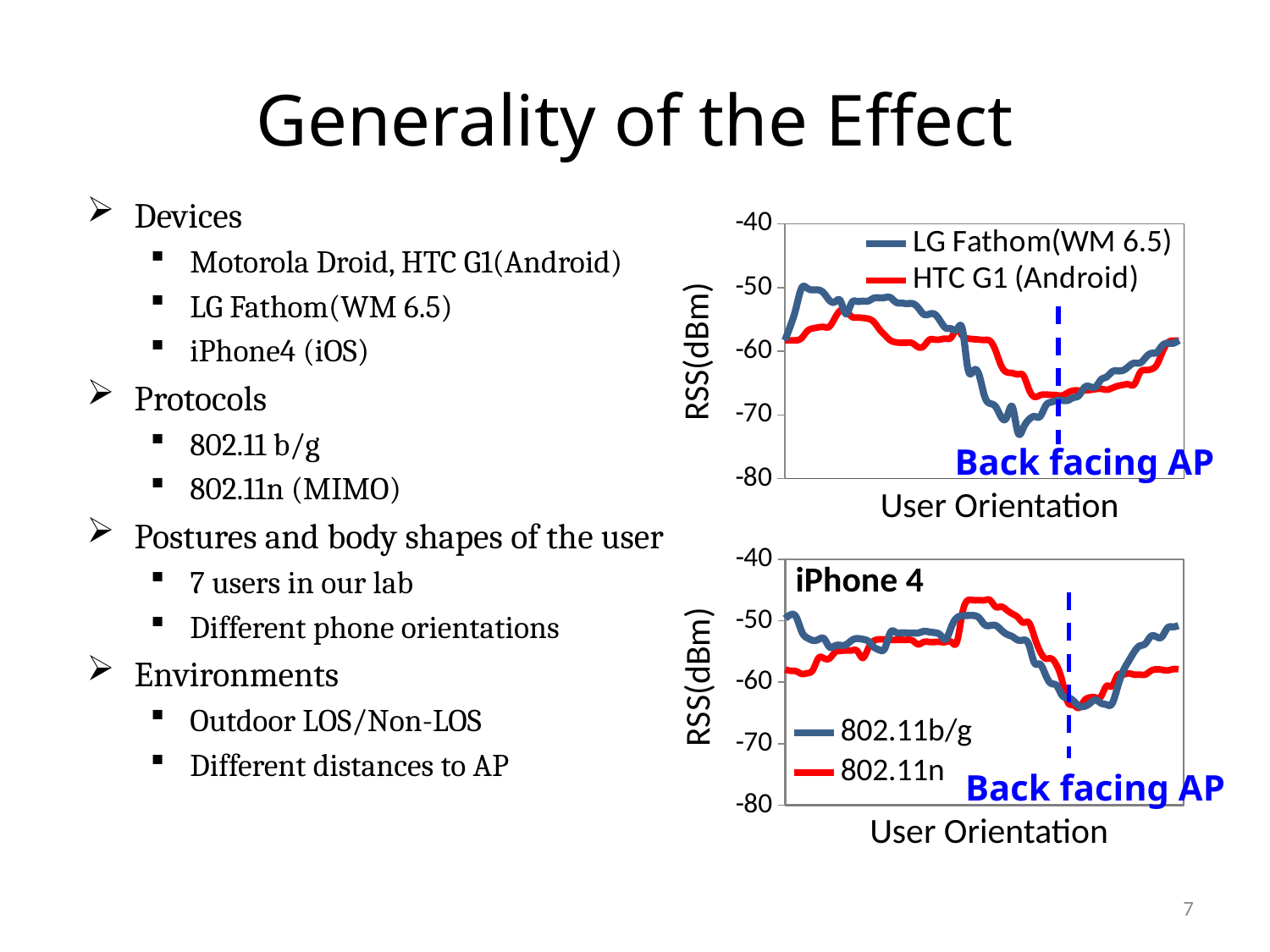
How many series does the legend of the top chart list? 2 In the bottom chart (iPhone 4), does the 802.11b/g line rise or fall after the dashed 'Back facing AP' line toward the right end? rise What kind of chart is the bottom chart (iPhone 4) on the slide? line chart How many series does the legend of the bottom chart (iPhone 4) list? 2 In the top chart, is the lowest value of the HTC G1 (Android) line greater or less than -70? greater In the bottom chart (iPhone 4), which two protocols are listed in the legend? 802.11b/g and 802.11n In the top chart, does the LG Fathom(WM 6.5) line rise or fall as it approaches the dashed 'Back facing AP' line from the left? fall In the bottom chart (iPhone 4), is the lowest value of the 802.11n line greater or less than -70? greater In the top chart, is the lowest value of the LG Fathom(WM 6.5) line greater or less than -70? less What kind of chart is the top chart on the slide? line chart In the top chart, which two series are listed in the legend? LG Fathom(WM 6.5) and HTC G1 (Android)